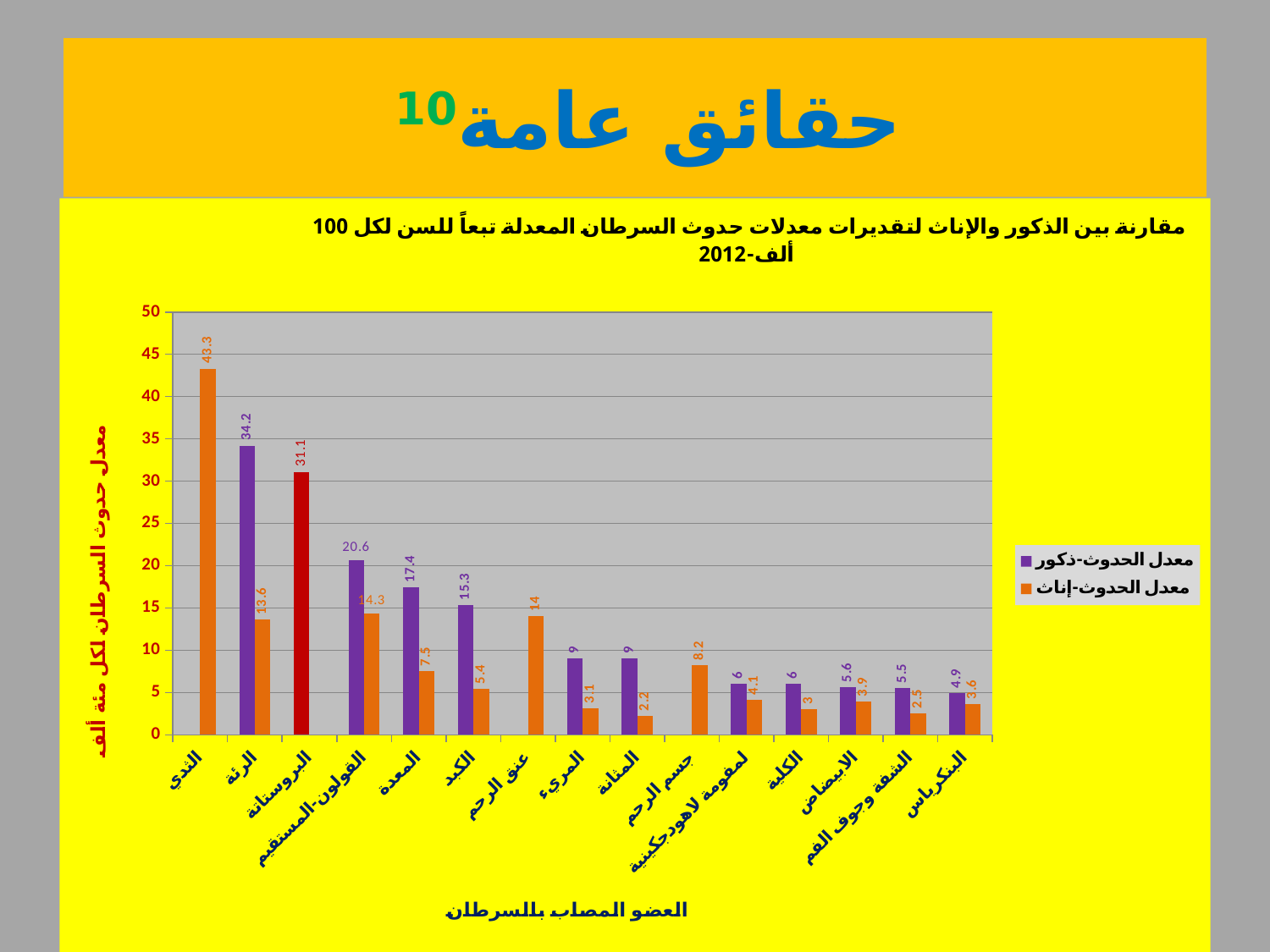
Which is larger: the male rate for المعدة or the male rate for الكبد? المعدة Which category has the highest value on the chart? الثدي What is the female incidence rate for القولون-المستقيم? 14.3 What is the value shown for البروستاتة? 31.1 What is the female incidence rate for عنق الرحم? 14 How many series does the legend list? 2 What is the male incidence rate (معدل الحدوث-ذكور) for الرئة? 34.2 What is the difference between the male and female incidence rates for الرئة? 20.6 What type of chart is shown on the slide? bar chart What is the female incidence rate (معدل الحدوث-إناث) for الثدي? 43.3 How many categories (organs) are shown on the x axis? 15 What is the difference between the male and female rates for الكبد? 9.9